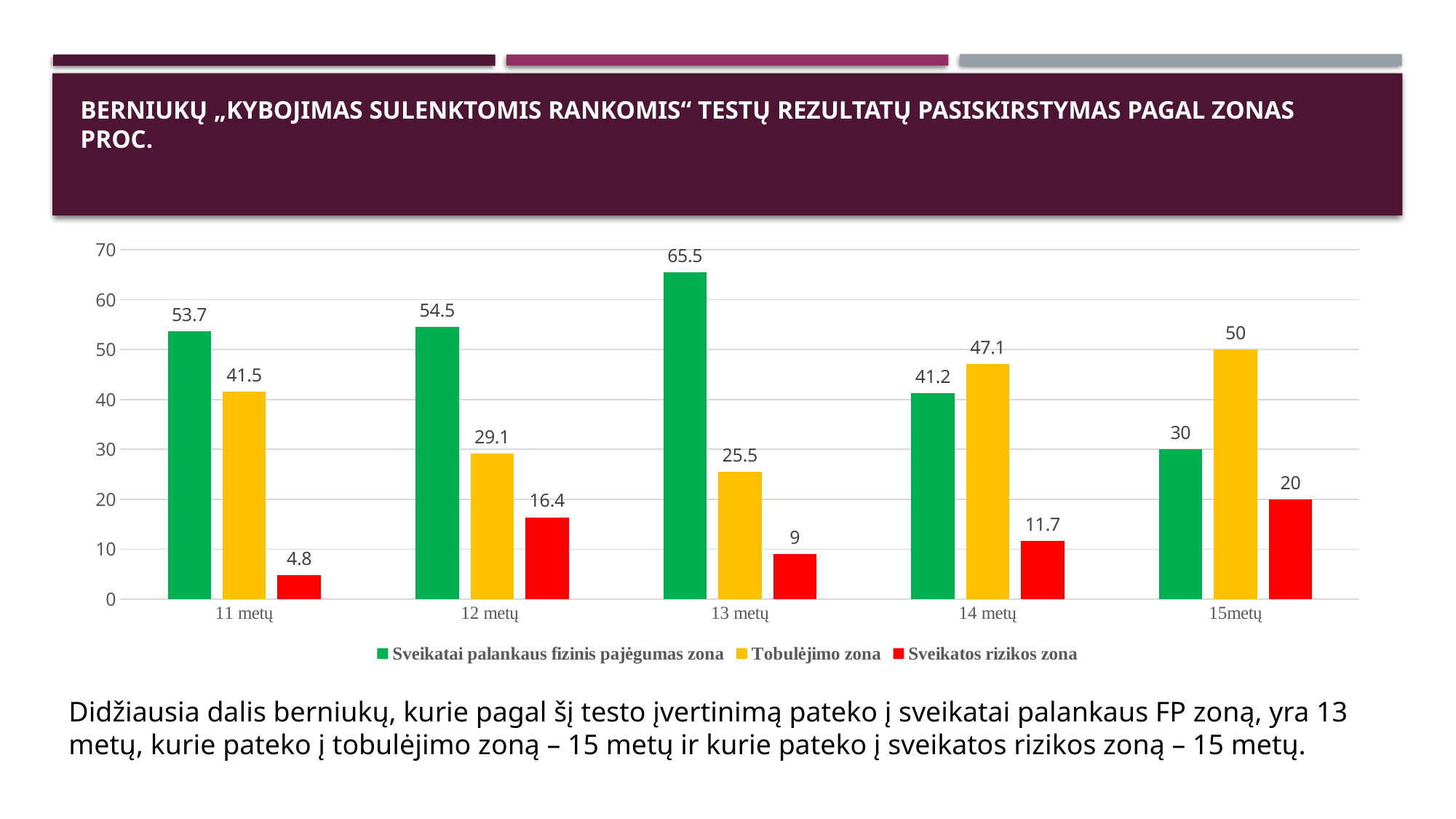
What is the value for 'Tobulėjimo zona' at 12 metų? 29.1 What kind of chart is shown on the slide? Bar chart What colour represents 'Sveikatos rizikos zona' in the chart? Red Which is larger at 14 metų: 'Sveikatai palankaus fizinis pajėgumas zona' or 'Tobulėjimo zona'? Tobulėjimo zona Which age group has the lowest value for 'Sveikatos rizikos zona'? 11 metų What is the difference between the 'Tobulėjimo zona' values at 15metų and 14 metų? 2.9 How many age groups are shown on the x axis? 5 How many series does the legend list? 3 What is the value for 'Sveikatai palankaus fizinis pajėgumas zona' at 13 metų? 65.5 Does the 'Sveikatos rizikos zona' value rise or fall from 11 metų to 12 metų? Rise Which age group has the highest value for 'Sveikatai palankaus fizinis pajėgumas zona'? 13 metų What is the value for 'Sveikatos rizikos zona' at 11 metų? 4.8